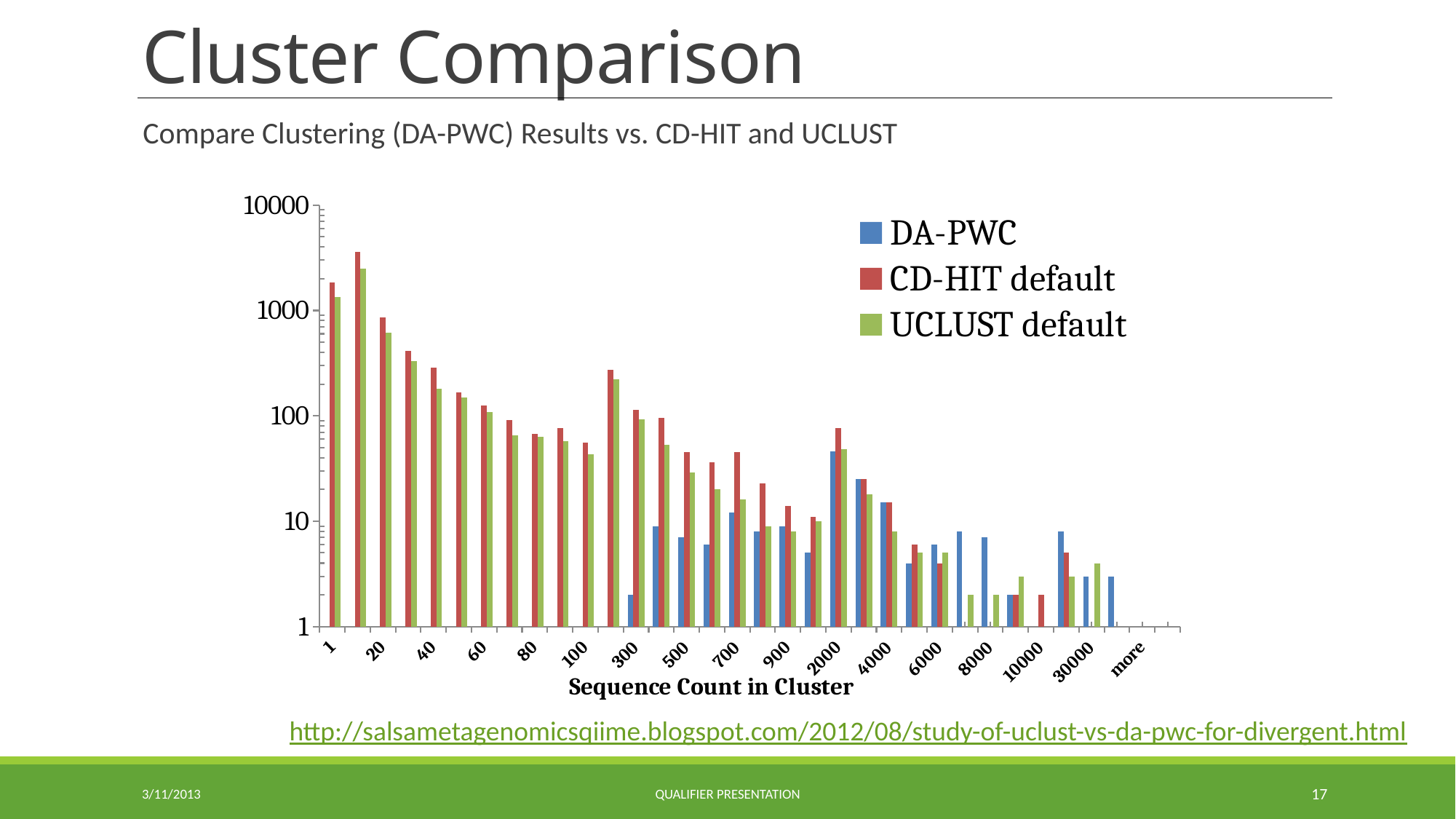
Do the CD-HIT default values generally rise or fall from sequence count 1 to sequence count 100? fall Is the UCLUST default value at sequence count 20 greater or less than 100? greater Is the UCLUST default value at sequence count 1 greater or less than 1000? greater What are the three series named in the legend? DA-PWC, CD-HIT default, UCLUST default Which series has the tallest bar anywhere on the chart? CD-HIT default What is the title of the x axis? Sequence Count in Cluster How many series does the legend list? 3 Is the CD-HIT default value at sequence count 20 greater or less than 1000? less What kind of chart is shown on the slide? bar chart At sequence count 1, which is larger: CD-HIT default or UCLUST default? CD-HIT default At sequence count 20, which is larger: CD-HIT default or UCLUST default? CD-HIT default